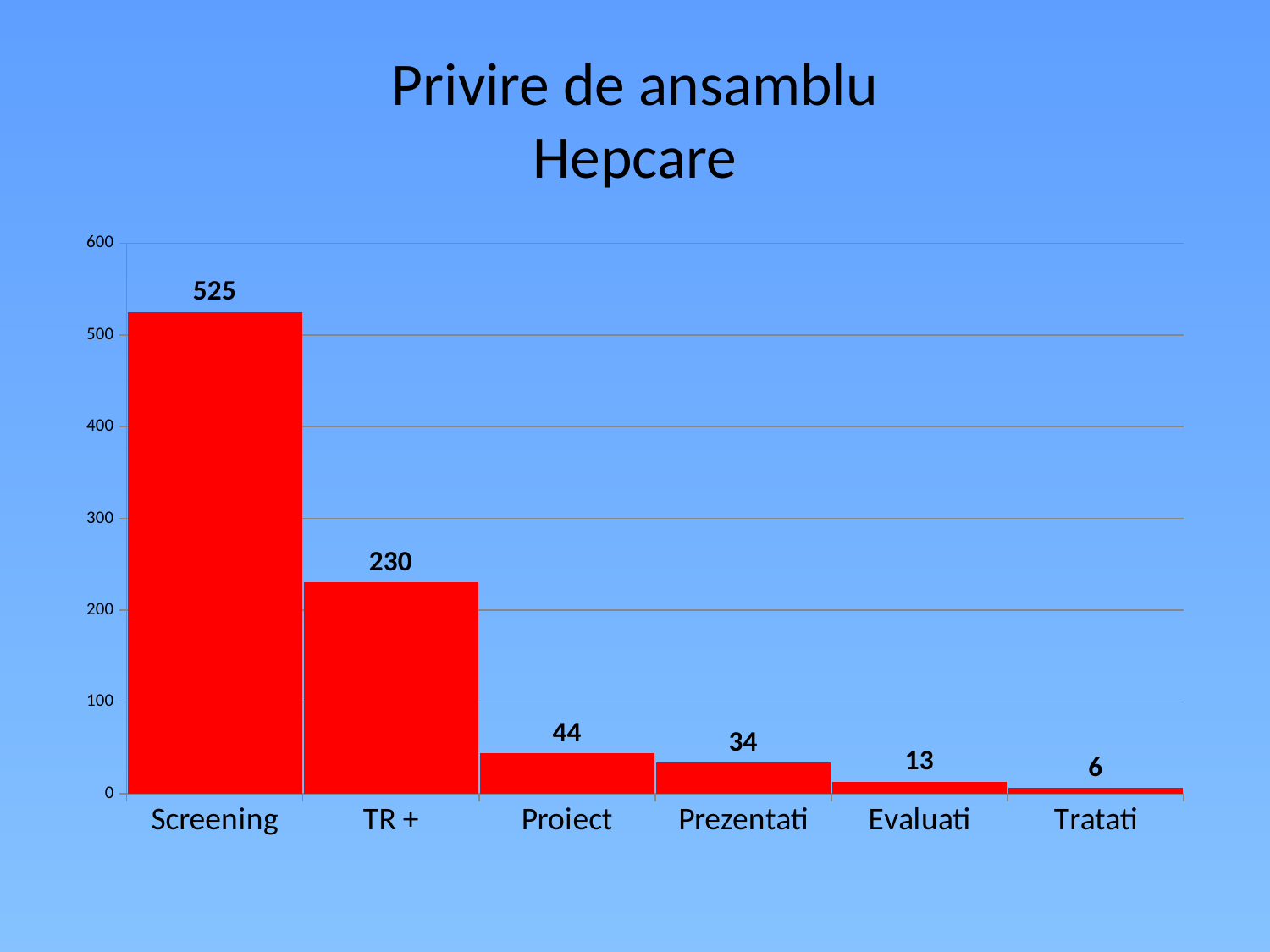
What is the difference between the values for Screening and TR +? 295 Do the values rise or fall from left to right along the x axis? Fall What is the value for TR +? 230 What is the value for Evaluati? 13 What is the value for Proiect? 44 What is the difference between the values for Proiect and Prezentati? 10 How many categories are shown on the x axis? 6 Which is larger, the value for Prezentati or the value for Evaluati? Prezentati Which category has the highest value? Screening What is the value for Screening? 525 Which category has the lowest value? Tratati What kind of chart is shown on the slide? Bar chart